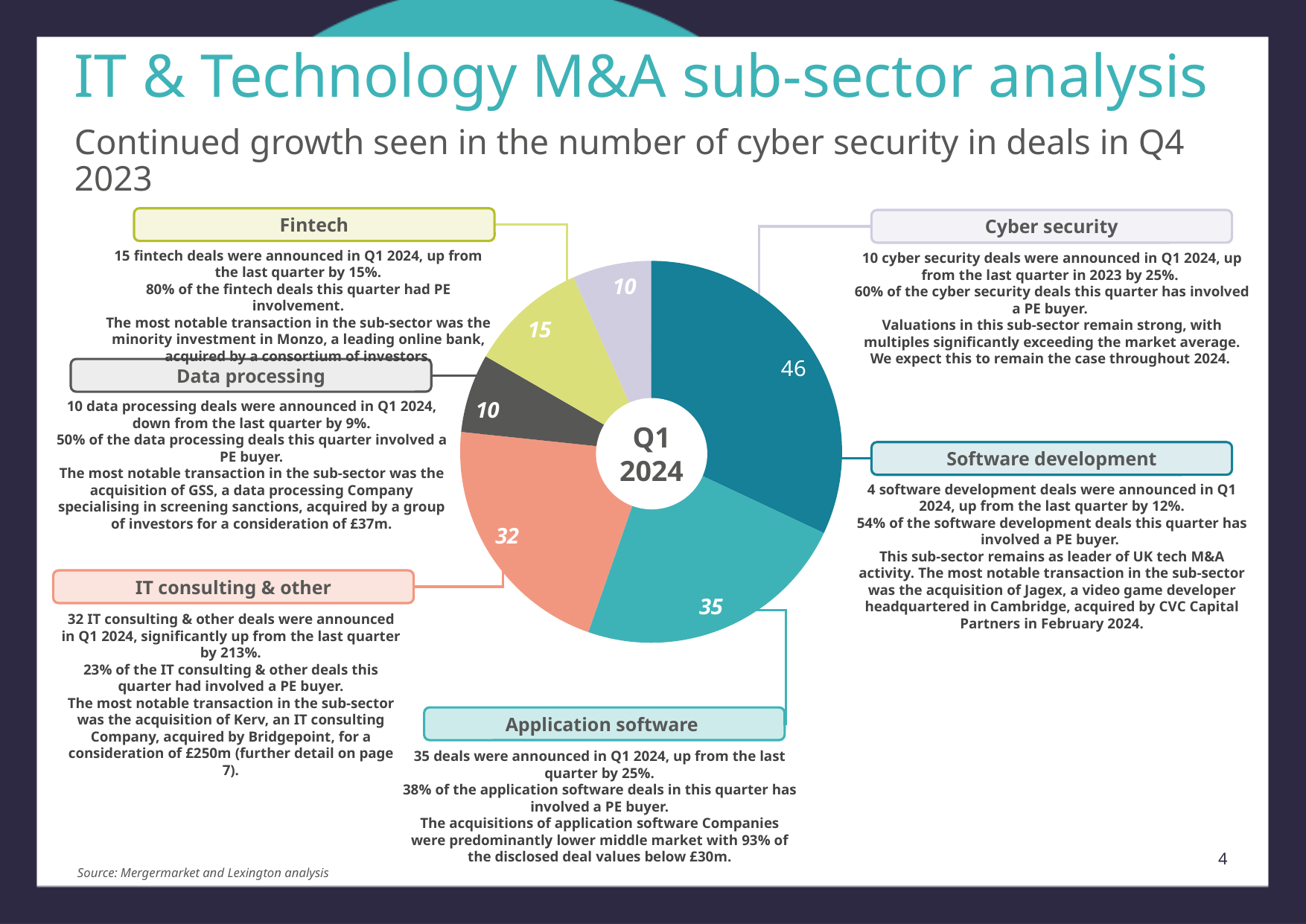
What is the difference between the Fintech and Data processing values in the pie chart? 5 How many slices does the pie chart have? 6 How many deals does the pie chart show for Application software? 35 Which two sub-sectors share the smallest slice value in the pie chart? Data processing and Cyber security How many deals does the pie chart show for Software development? 46 How many deals does the pie chart show for IT consulting & other? 32 Which sub-sector has the largest slice of the pie chart? Software development How many deals does the pie chart show for Fintech? 15 Which is larger in the pie chart, IT consulting & other or Application software? Application software What kind of chart is shown on the slide? pie chart What text is shown in the centre of the pie chart? Q1 2024 What is the difference between the Software development and Application software values in the pie chart? 11